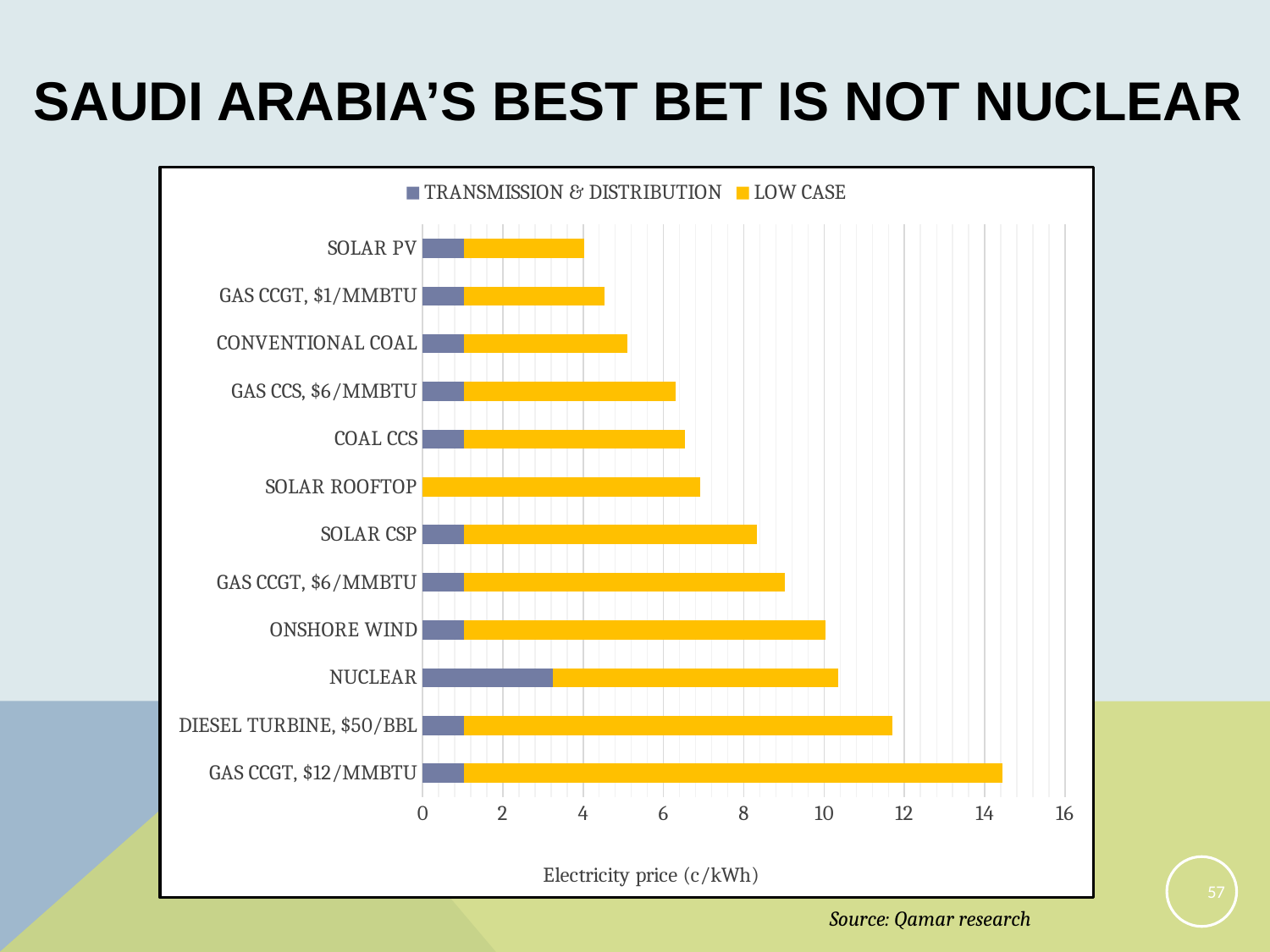
Is the total electricity price for SOLAR CSP greater or less than 8? greater What is the label of the x axis? Electricity price (c/kWh) Which has a higher total electricity price, NUCLEAR or SOLAR PV? NUCLEAR How many categories are plotted on the chart? 12 Is the total electricity price for DIESEL TURBINE, $50/BBL greater or less than 12? less Which category has the highest total electricity price? GAS CCGT, $12/MMBTU Is the total electricity price for CONVENTIONAL COAL greater or less than 6? less How many series does the legend list? 2 Which category has the largest TRANSMISSION & DISTRIBUTION segment? NUCLEAR What kind of chart is shown on the slide? bar chart Which category has the lowest total electricity price? SOLAR PV